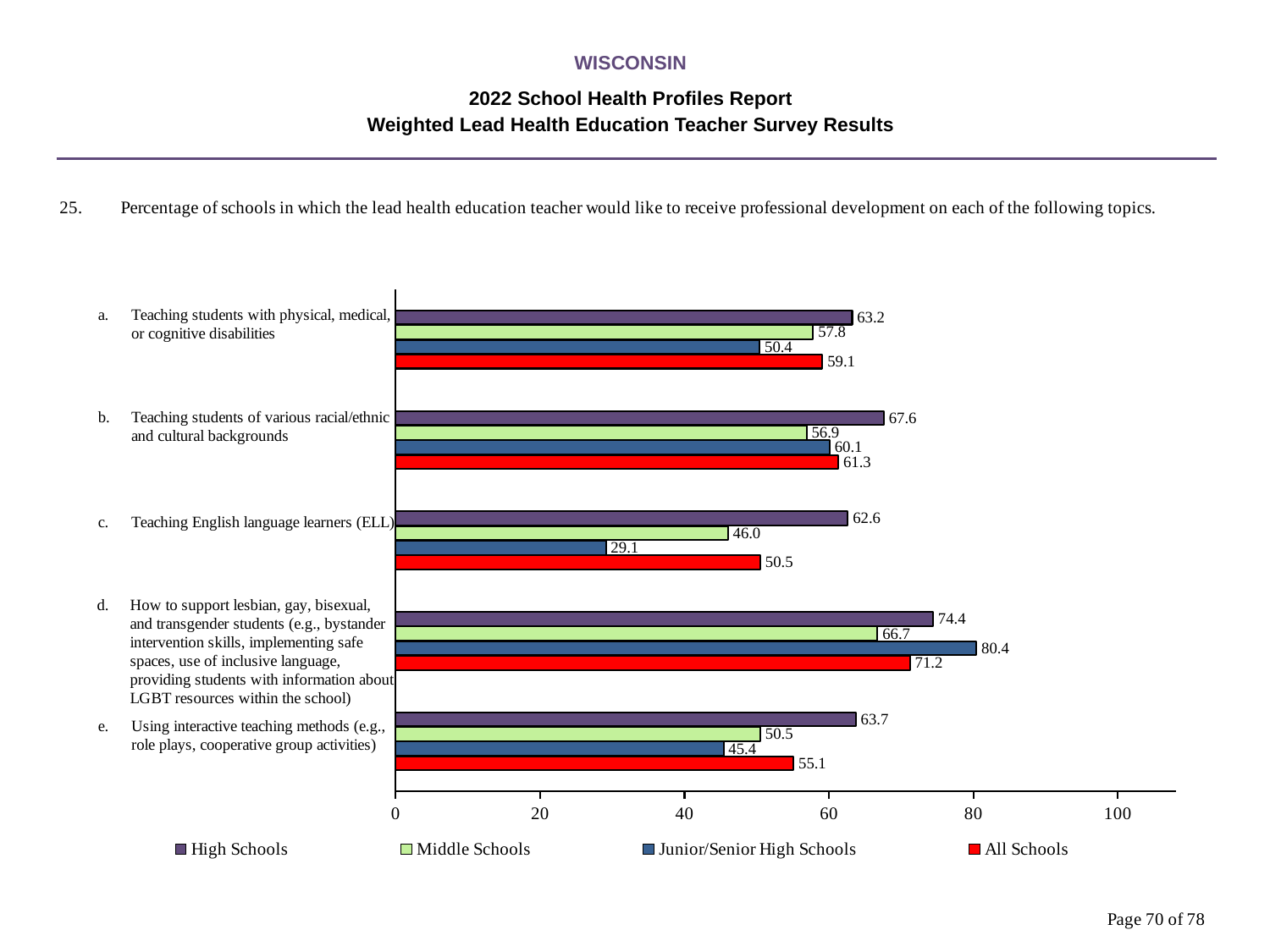
How many topics (categories) are shown on the chart? 5 What colour are the All Schools bars? Red What is the value for High Schools for topic a, teaching students with physical, medical, or cognitive disabilities? 63.2 What is the value for Junior/Senior High Schools for topic c, teaching English language learners (ELL)? 29.1 Which topic has the lowest value for Middle Schools? c. Teaching English language learners (ELL) What is the value for All Schools for topic d, how to support lesbian, gay, bisexual, and transgender students? 71.2 How many series does the legend list? 4 For topic b, teaching students of various racial/ethnic and cultural backgrounds, which is larger: the High Schools value or the All Schools value? High Schools What is the difference between the High Schools and Middle Schools values for topic c, teaching English language learners (ELL)? 16.6 Which topic has the highest value for Junior/Senior High Schools? d. How to support lesbian, gay, bisexual, and transgender students What is the value for Middle Schools for topic e, using interactive teaching methods? 50.5 What kind of chart is shown on the slide? Bar chart